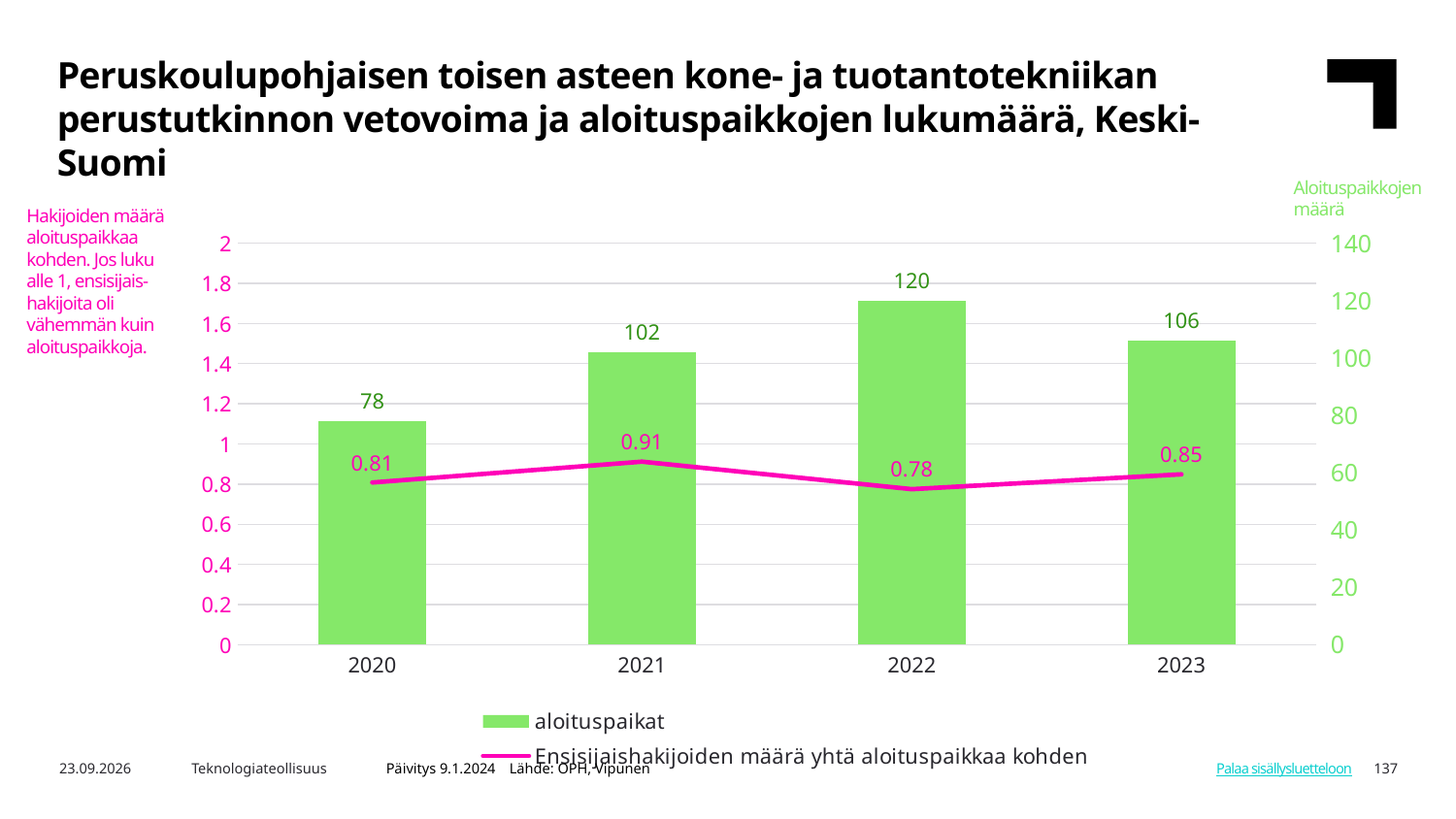
Which year has the lowest value of Ensisijaishakijoiden määrä yhtä aloituspaikkaa kohden? 2022 Which year has the highest value of aloituspaikat? 2022 Is the aloituspaikat value for 2023 greater or less than 100? greater Which is larger, the aloituspaikat value for 2021 or for 2023? 2023 What is the value of Ensisijaishakijoiden määrä yhtä aloituspaikkaa kohden for 2021? 0.91 What colour are the aloituspaikat bars? Green What is the difference in aloituspaikat between 2022 and 2020? 42 What is the value of aloituspaikat for 2022? 120 How many series does the legend list? 2 How many years are shown on the x axis? 4 What kind of chart is shown on the slide? Combined bar and line chart What is the value of aloituspaikat for 2020? 78